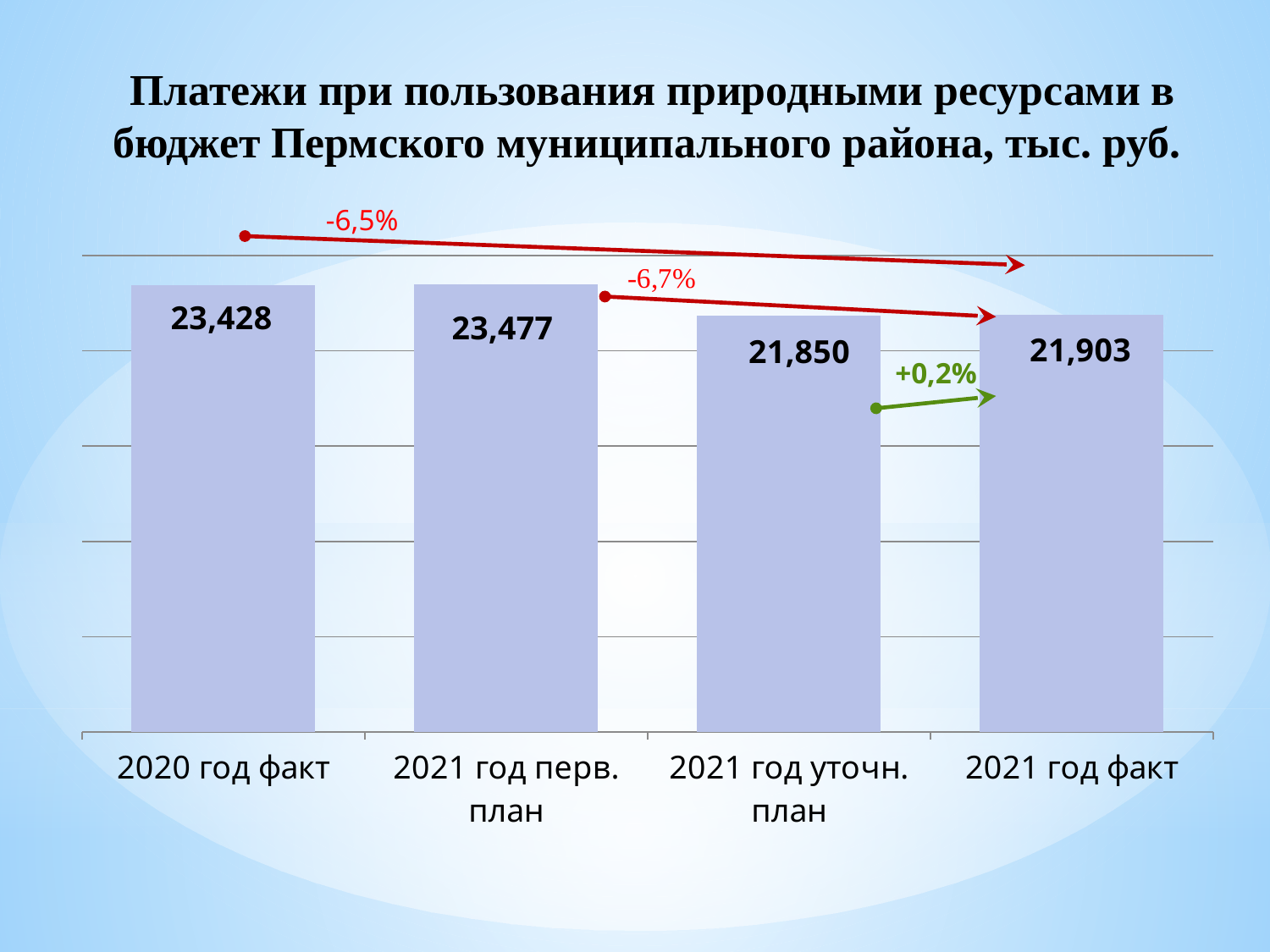
How many categories are shown in the chart? 4 What is the value for 2020 год факт? 23,428 What is the difference between the values for 2021 год факт and 2021 год уточн. план? 53 What is the value for 2021 год уточн. план? 21,850 Which category has the lowest value? 2021 год уточн. план What kind of chart is shown on the slide? Bar chart What is the difference between the values for 2020 год факт and 2021 год уточн. план? 1,578 Which category has the highest value? 2021 год перв. план Which is larger, the value for 2020 год факт or the value for 2021 год факт? 2020 год факт What is the value for 2021 год перв. план? 23,477 What is the value for 2021 год факт? 21,903 What percentage change is shown by the green arrow between 2021 год уточн. план and 2021 год факт? +0,2%